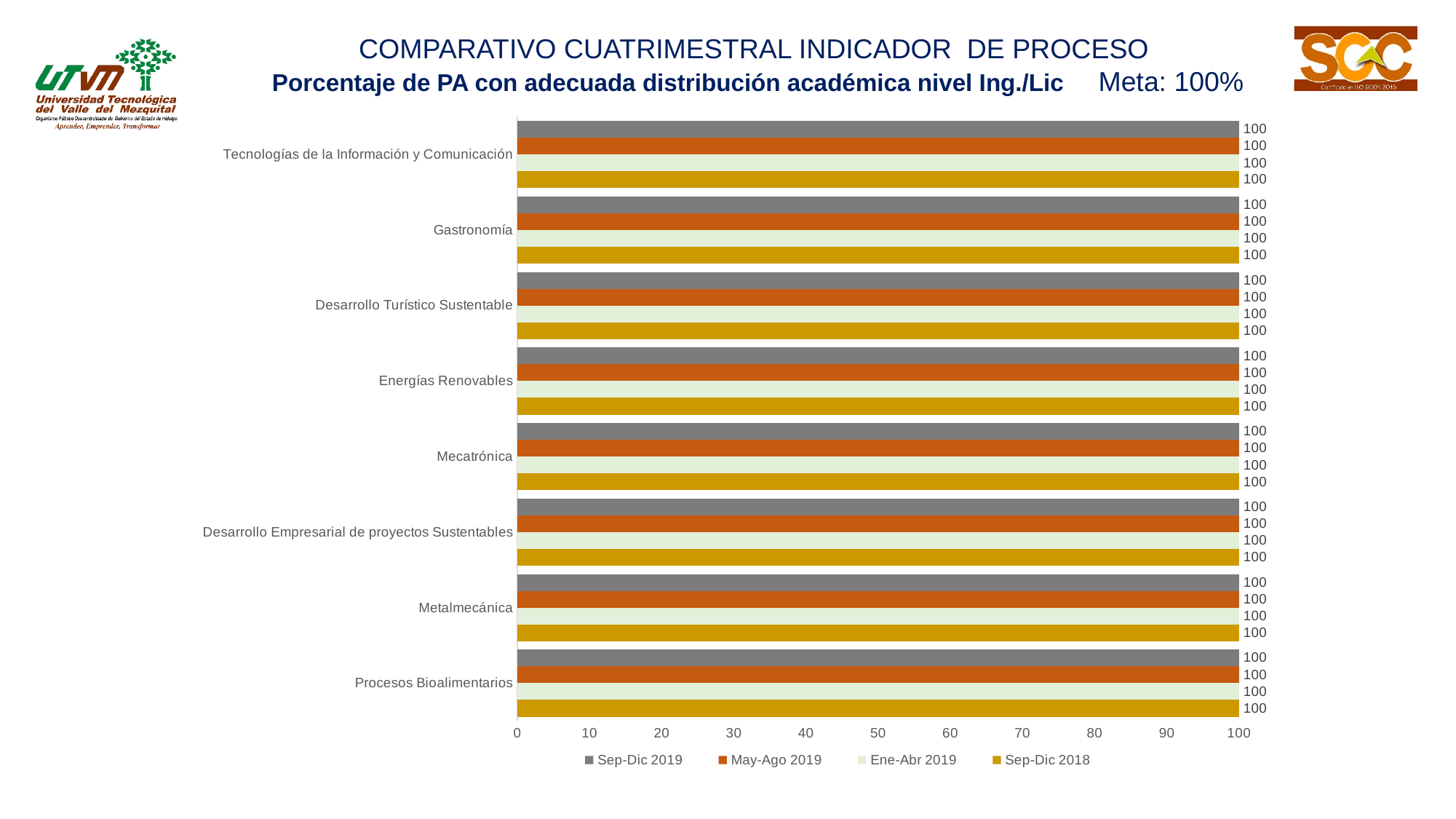
What is the value for Gastronomía in the Sep-Dic 2019 series? 100 What is the value for Mecatrónica in the Sep-Dic 2018 series? 100 Is the value for Desarrollo Turístico Sustentable in the Ene-Abr 2019 series greater or less than 90? greater What kind of chart is shown on the slide? bar chart What is the value for Energías Renovables in the May-Ago 2019 series? 100 How many series does the legend list? 4 Which series is shown in the legend with the orange colour? May-Ago 2019 What is the value for Procesos Bioalimentarios in the Ene-Abr 2019 series? 100 What is the value for Tecnologías de la Información y Comunicación in the Sep-Dic 2019 series? 100 What is the difference between the Sep-Dic 2019 value and the Sep-Dic 2018 value for Metalmecánica? 0 How many categories (programs) are shown on the chart? 8 What is the target (Meta) stated on the slide? 100%